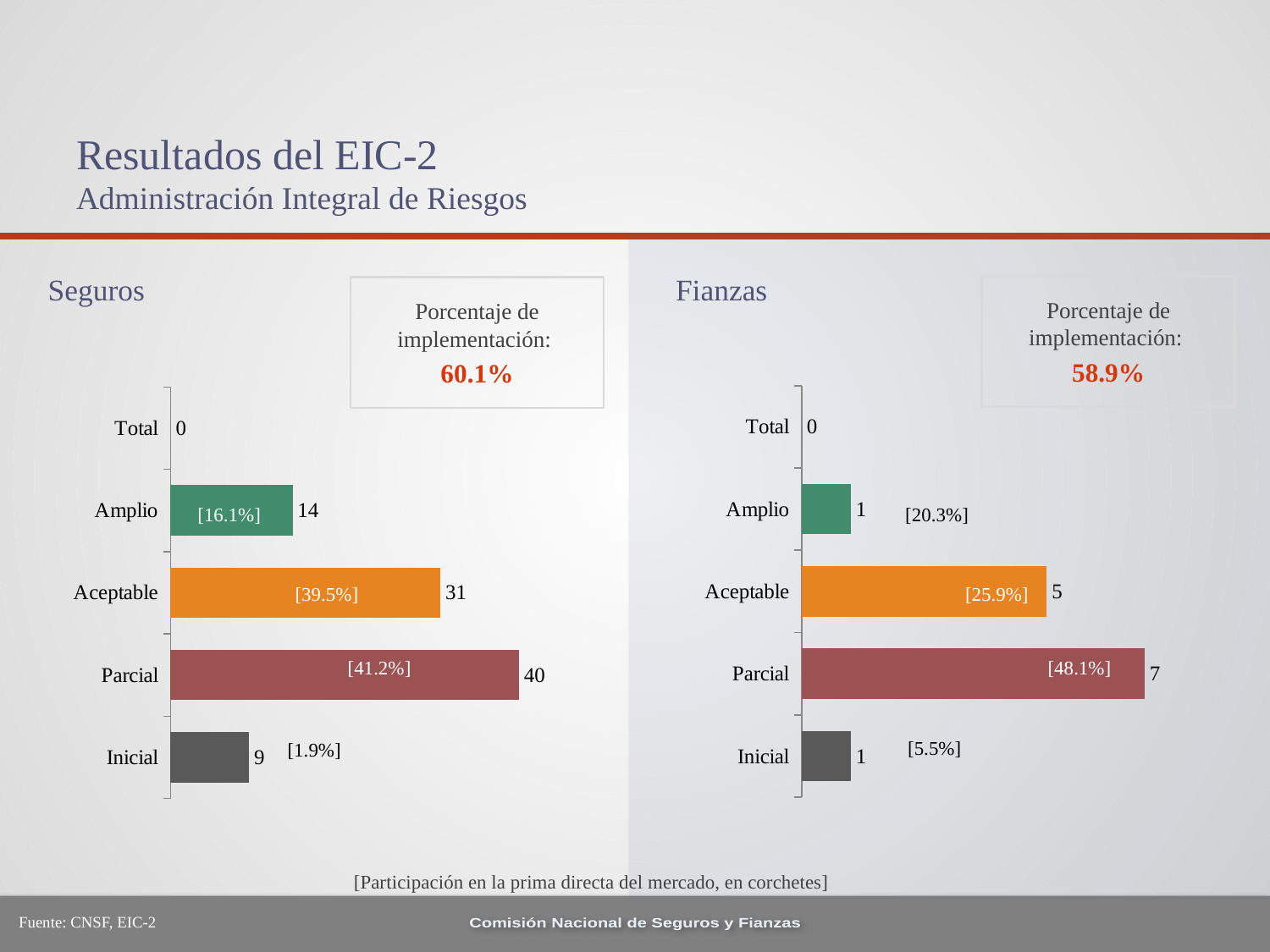
In the Seguros chart, what is the value for Parcial? 40 In the Fianzas chart, which category has the lowest value? Total In the Fianzas chart, what is the value for Parcial? 7 What type of chart is the Seguros chart? Bar chart In the Fianzas chart, what is the value for Aceptable? 5 In the Seguros chart, which category has the highest value? Parcial In the Fianzas chart, what bracketed percentage is shown for Inicial? [5.5%] In the Seguros chart, which is larger, the value for Amplio or the value for Inicial? Amplio In the Seguros chart, what is the value for Aceptable? 31 In the Seguros chart, what bracketed percentage is shown for Amplio? [16.1%] In the Seguros chart, what is the difference between the values for Parcial and Aceptable? 9 How many categories does the Fianzas chart show? 5